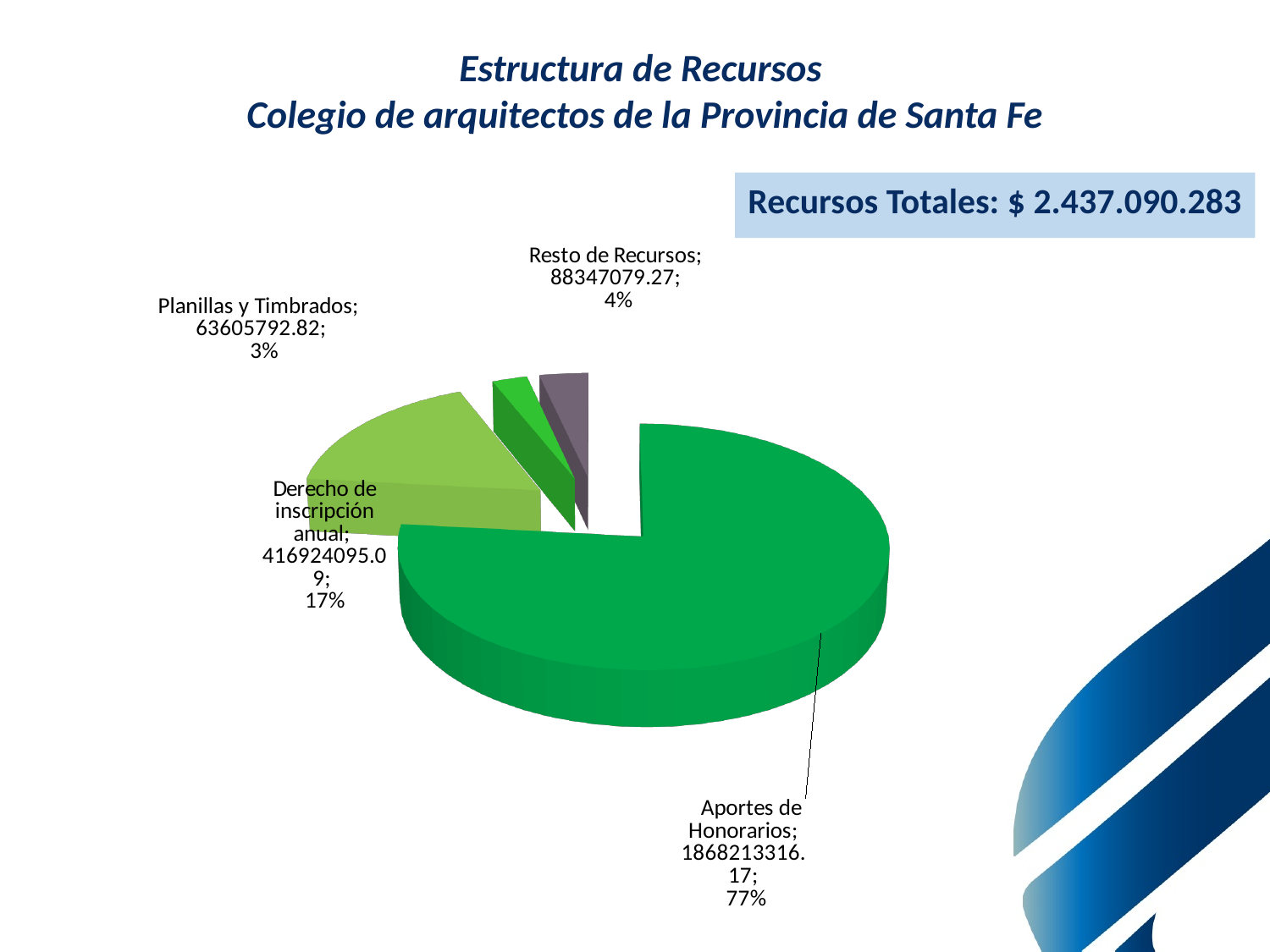
What percentage share does Derecho de inscripción anual have? 17% What total amount of resources (Recursos Totales) is stated on the slide? $ 2.437.090.283 How many slices does the pie chart have? 4 What is the value shown for Derecho de inscripción anual? 416924095.09 Which category has the largest slice of the pie chart? Aportes de Honorarios What percentage share does Aportes de Honorarios have in the pie chart? 77% What is the difference in percentage points between the share of Aportes de Honorarios and the share of Derecho de inscripción anual? 60 What kind of chart is shown on the slide? Pie chart What is the value shown for Planillas y Timbrados? 63605792.82 Which is larger, the share for Resto de Recursos or the share for Planillas y Timbrados? Resto de Recursos What is the value shown for Resto de Recursos? 88347079.27 Which category has the smallest slice of the pie chart? Planillas y Timbrados